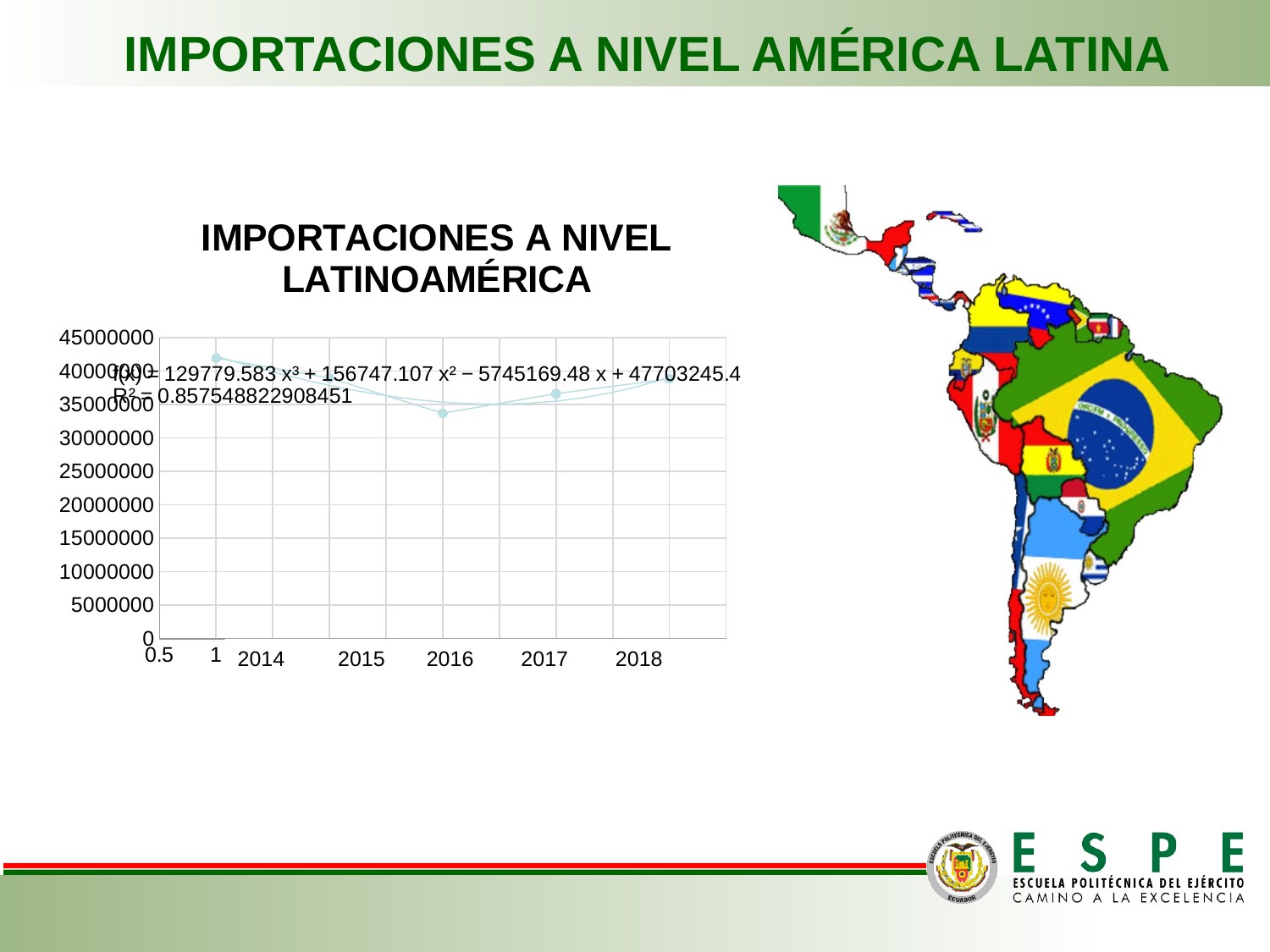
Do the values rise or fall from 2014 to 2016? fall Which is larger, the value for 2018 or the value for 2016? 2018 How many years are plotted on the x axis of the chart? 5 Is the value for 2014 greater or less than 40000000? greater What is the title of the chart? IMPORTACIONES A NIVEL LATINOAMÉRICA Which year has the highest value in the chart? 2014 Which is larger, the value for 2014 or the value for 2016? 2014 What kind of chart is shown on the slide? line chart What R² value is shown for the trendline on the chart? 0.857548822908451 Which year has the lowest value in the chart? 2016 Is the value for 2016 greater or less than 30000000? greater Is the value for 2016 greater or less than 35000000? less